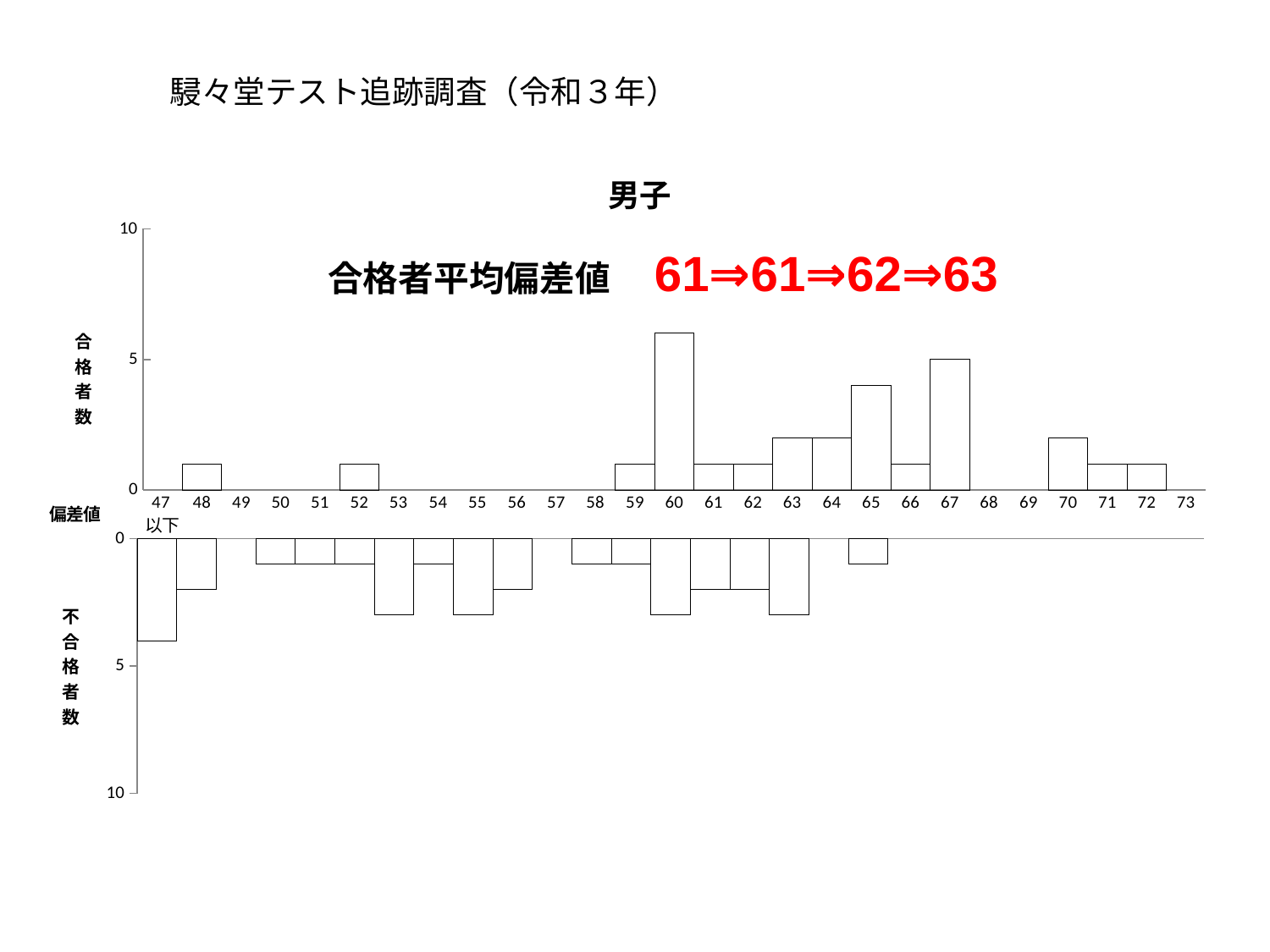
What kind of chart is used on this slide for 合格者数 and 不合格者数? bar chart In the top chart (合格者数), what is the value for 偏差値 67? 5 In the bottom chart (不合格者数), is the value for 47以下 greater or less than 5? less How many 偏差値 categories are shown on the x axis (from 47 to 73)? 27 In the bottom chart (不合格者数), which 偏差値 category has the highest number of failures? 47以下 In the top chart (合格者数), which is larger, the value for 偏差値 67 or 偏差値 70? 67 In the top chart (合格者数), is the value for 偏差値 65 greater or less than 5? less In the top chart (合格者数), which is larger, the value for 偏差値 60 or 偏差値 65? 60 In the top chart (合格者数), is the value for 偏差値 60 greater or less than 5? greater In the bottom chart (不合格者数), which is larger, the value for 偏差値 53 or 偏差値 54? 53 In the top chart (合格者数), which 偏差値 has the highest number of passers? 60 What is the 合格者平均偏差値 sequence shown in red text on the slide? 61⇒61⇒62⇒63